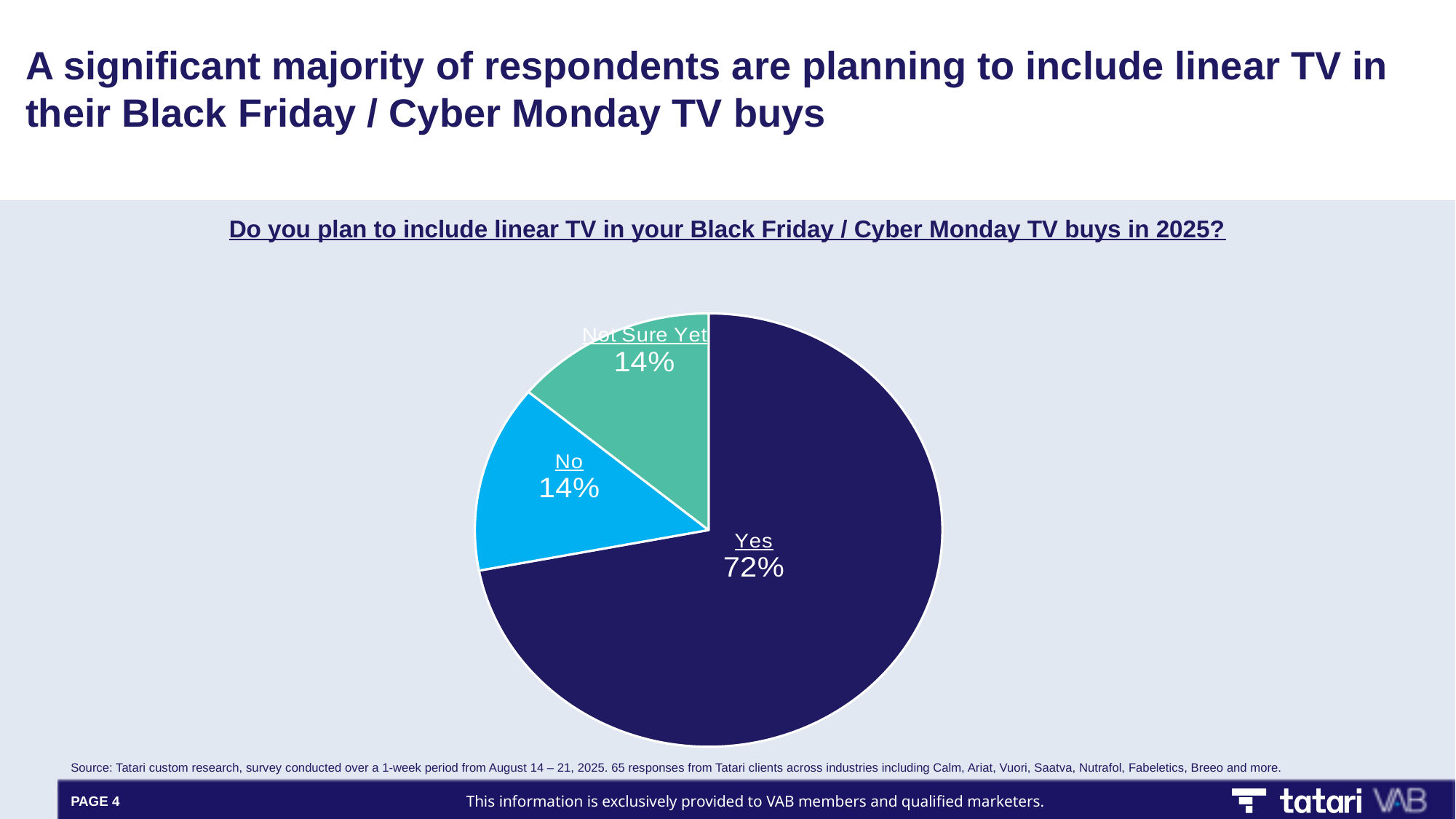
What share of respondents answered "Yes"? 72% What share of respondents answered "Not Sure Yet"? 14% Which is larger, the "Yes" share or the "Not Sure Yet" share? Yes What colour is the "Yes" slice of the pie? Dark navy blue Which response has the largest share of the pie? Yes What share of respondents answered "No"? 14% What kind of chart is shown on the slide? Pie chart How many slices does the pie chart have? 3 What is the difference in percentage points between the "Yes" share and the "No" share? 58 What is the combined share of "No" and "Not Sure Yet" responses? 28% What question does the pie chart's title ask? Do you plan to include linear TV in your Black Friday / Cyber Monday TV buys in 2025?